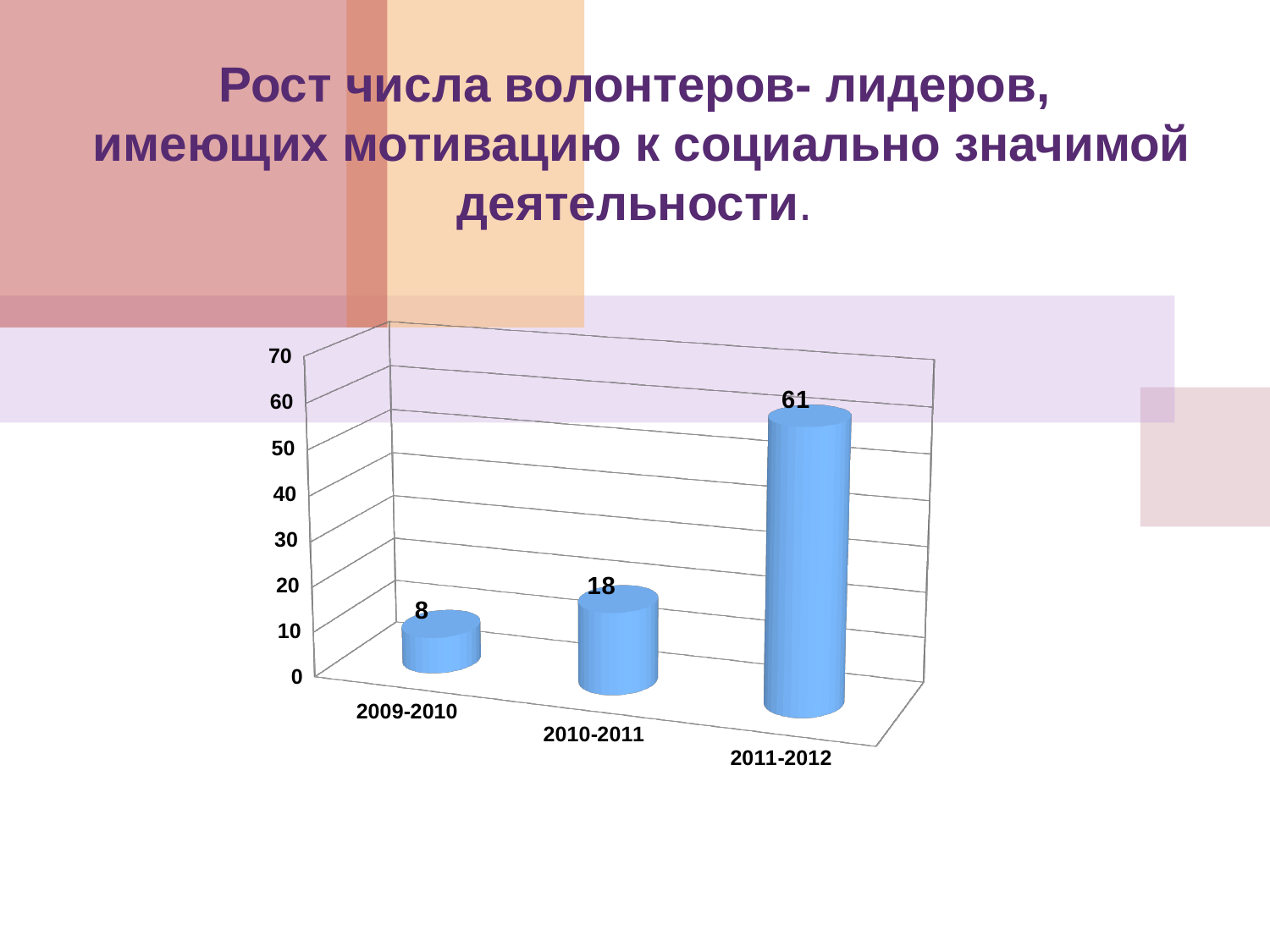
Which period has the lowest value? 2009-2010 How many periods are shown on the x axis? 3 What is the value for 2010-2011? 18 Do the values rise or fall from 2009-2010 to 2011-2012? rise What is the value for 2011-2012? 61 Which period has the highest value? 2011-2012 What is the difference between the values for 2011-2012 and 2010-2011? 43 What kind of chart is shown on the slide? bar chart What is the value for 2009-2010? 8 Which is larger, the value for 2010-2011 or the value for 2009-2010? 2010-2011 Is the value for 2011-2012 greater or less than 50? greater What is the difference between the values for 2010-2011 and 2009-2010? 10